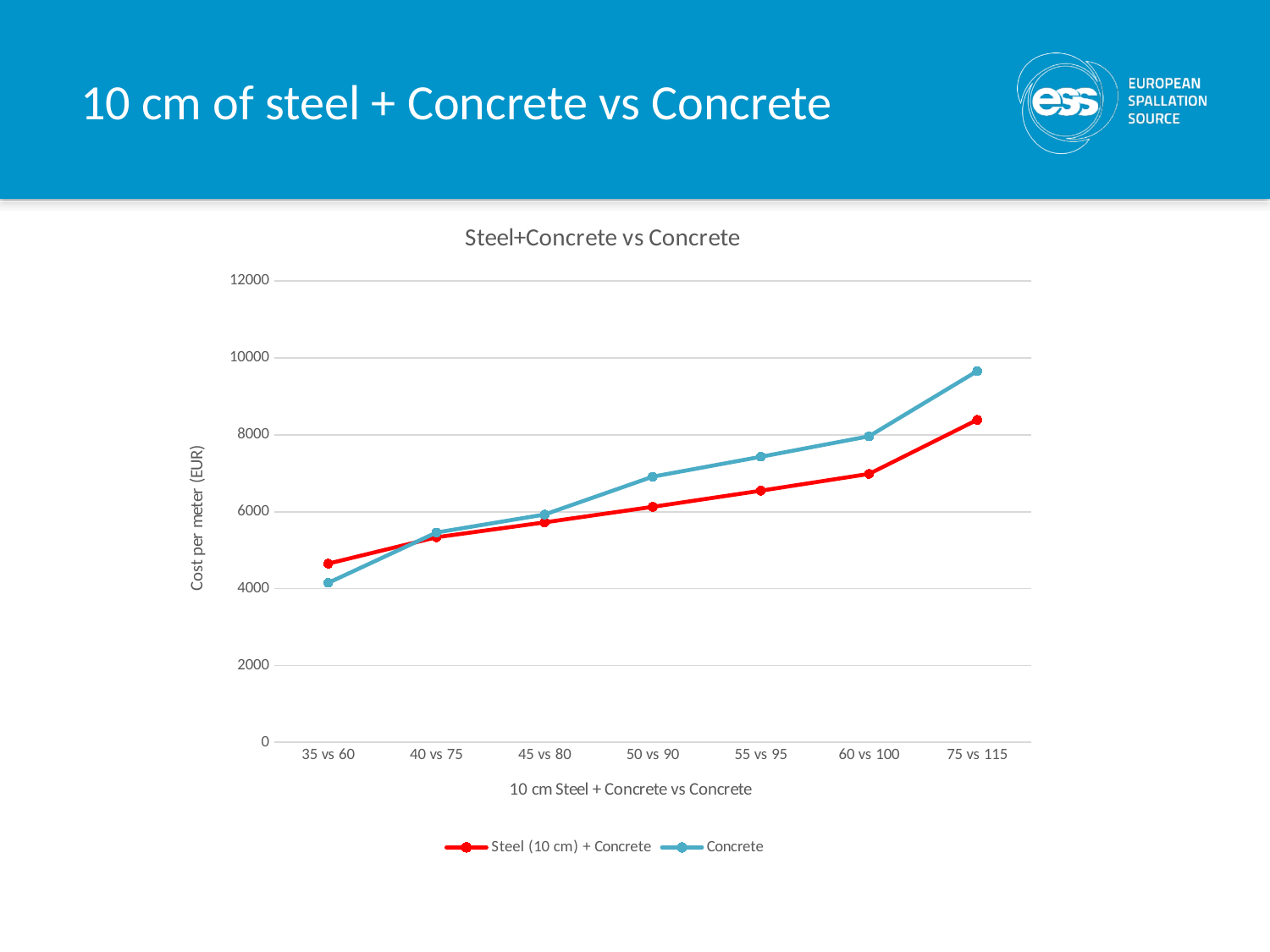
Is the value for Concrete at 50 vs 90 greater or less than 6000? greater At 35 vs 60, which series has the higher value, Steel (10 cm) + Concrete or Concrete? Steel (10 cm) + Concrete How many categories are shown on the x axis? 7 Is the value for Steel (10 cm) + Concrete at 60 vs 100 greater or less than 8000? less Is the value for Concrete at 75 vs 115 greater or less than 8000? greater At 75 vs 115, which series has the higher value, Steel (10 cm) + Concrete or Concrete? Concrete How many series does the legend list? 2 For which category is the Concrete value highest? 75 vs 115 Do the values for Concrete rise or fall from left to right along the x axis? rise What kind of chart is shown on the slide? line chart What is the title of the vertical axis? Cost per meter (EUR)